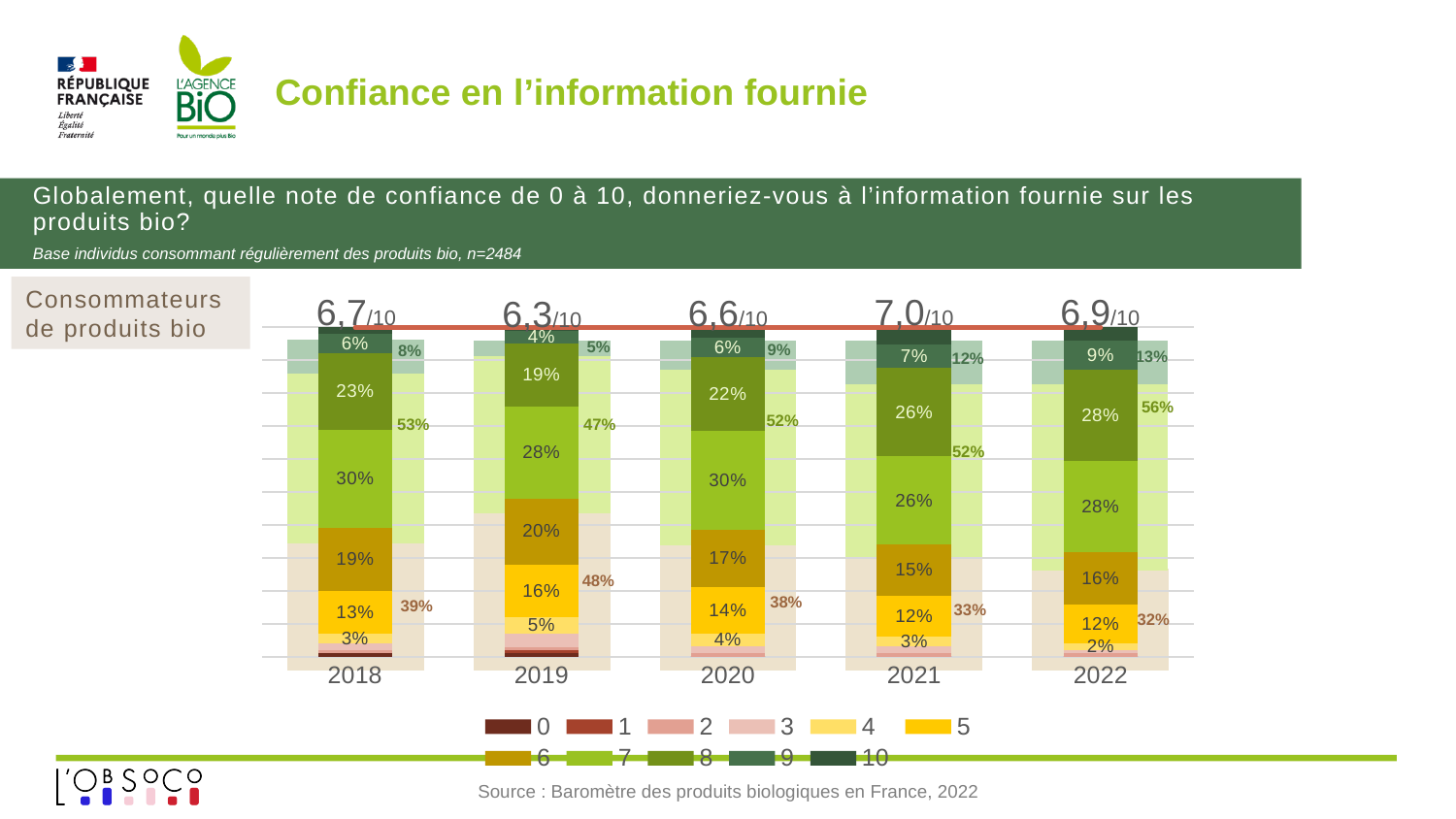
What kind of chart is shown on the slide? Stacked bar chart What is the difference in percentage points between the share giving a score of 7 in 2018 and in 2019? 2 points Which year has the highest average confidence score shown above the bars? 2021 What percentage of respondents gave a score of 6 in 2019? 20% What is the title of the slide containing the chart? Confiance en l'information fournie Which year has the larger share of respondents giving a score of 8: 2019 or 2021? 2021 What percentage of respondents gave a score of 8 in 2022? 28% Which year has the lowest average confidence score shown above the bars? 2019 What percentage of respondents gave a score of 7 in 2020? 30% How many series does the chart legend list? 11 What is the average confidence score shown above the bar for 2021? 7,0/10 How many years are shown along the x axis of the chart? 5